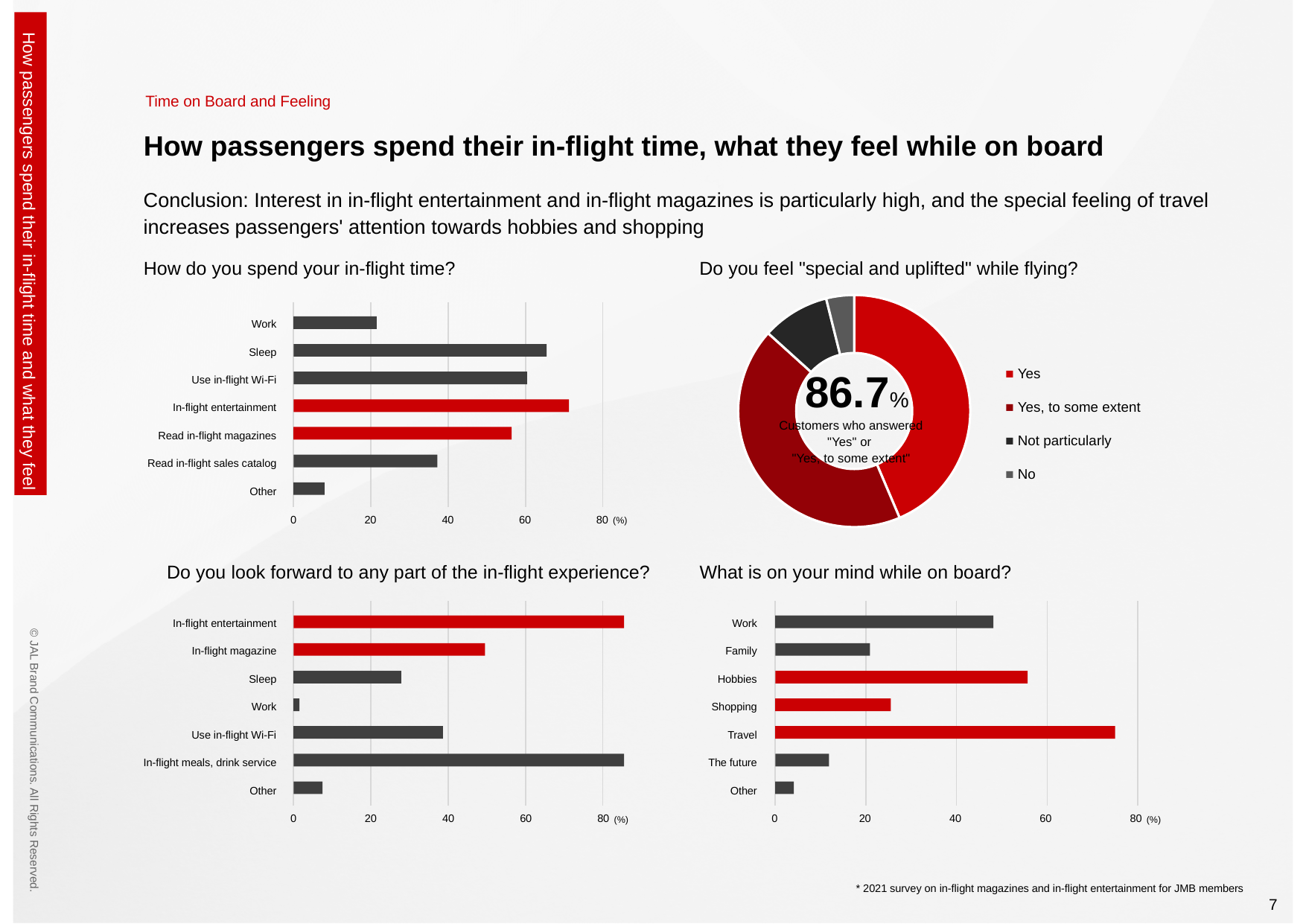
In the chart "How do you spend your in-flight time?", which category has the highest value? In-flight entertainment In the chart "What is on your mind while on board?", which is larger, Hobbies or Shopping? Hobbies In the chart "How do you spend your in-flight time?", is the value for Sleep greater or less than 60? greater In the chart "Do you feel "special and uplifted" while flying?", how many entries does the legend list? 4 In the chart "Do you feel "special and uplifted" while flying?", what percentage of customers answered "Yes" or "Yes, to some extent"? 86.7% In the chart "Do you look forward to any part of the in-flight experience?", which category has the lowest value? Work What kind of chart is "What is on your mind while on board?"? Bar chart In the chart "How do you spend your in-flight time?", which category has the lowest value? Other In the chart "What is on your mind while on board?", which category has the highest value? Travel What kind of chart is "Do you feel "special and uplifted" while flying?"? Pie (donut) chart In the chart "Do you look forward to any part of the in-flight experience?", is the value for In-flight meals, drink service greater or less than 80? greater In the chart "How do you spend your in-flight time?", how many categories are shown? 7